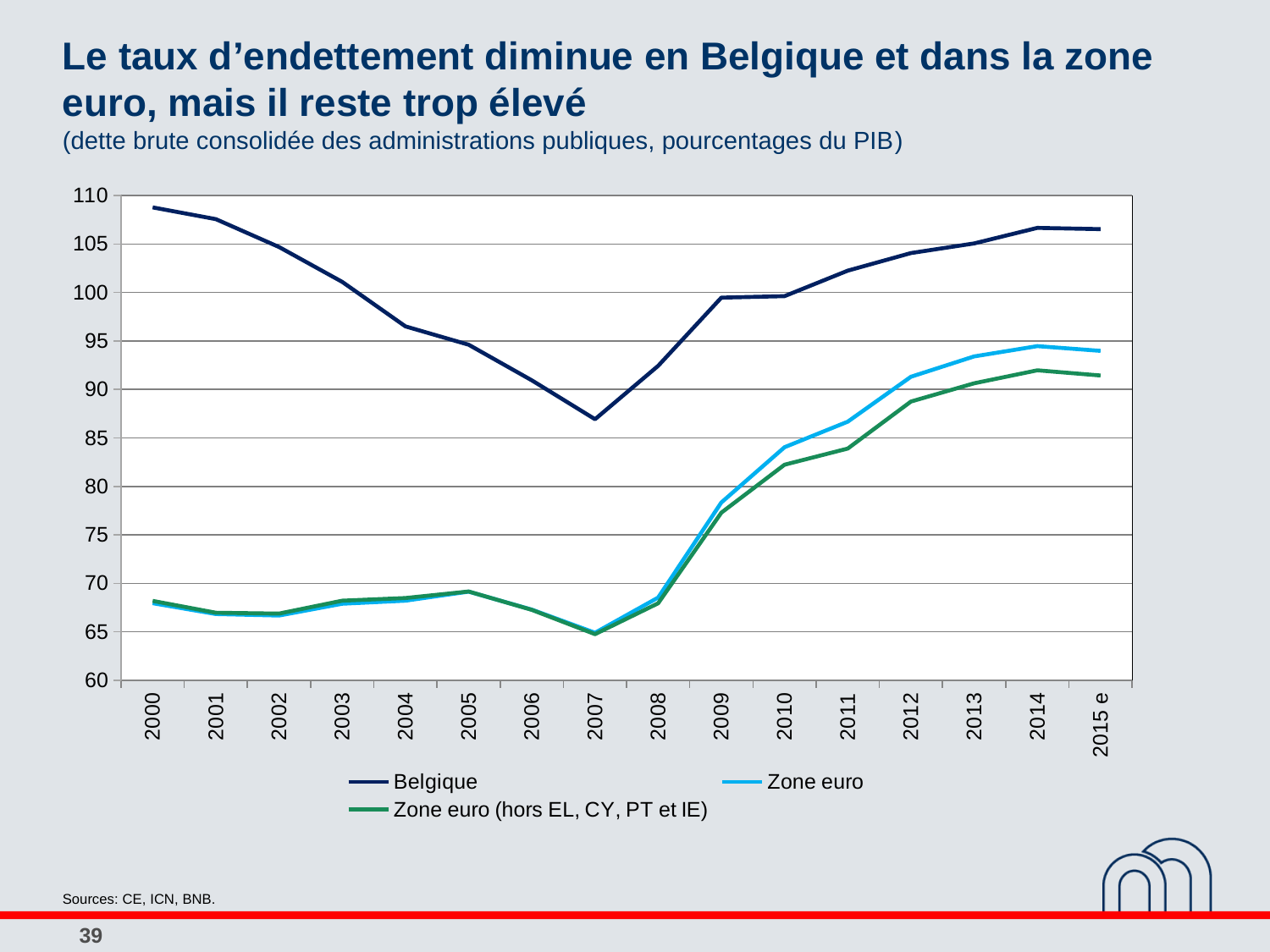
In 2014, which series has the larger value: Belgique or Zone euro? Belgique Does the Zone euro series rise or fall between 2008 and 2014? rise In which year does the Belgique series reach its highest value? 2000 How many years are shown along the x axis? 16 How many series does the legend list? 3 In which year does the Belgique series reach its lowest value? 2007 Does the Belgique series rise or fall between 2000 and 2007? fall Is the value for Zone euro in 2000 greater or less than 70? less Is the value for Belgique in 2007 greater or less than 90? less What kind of chart is shown on the slide? line chart In 2014, which is larger: Zone euro or Zone euro (hors EL, CY, PT et IE)? Zone euro Is the value for Zone euro in 2014 greater or less than 90? greater